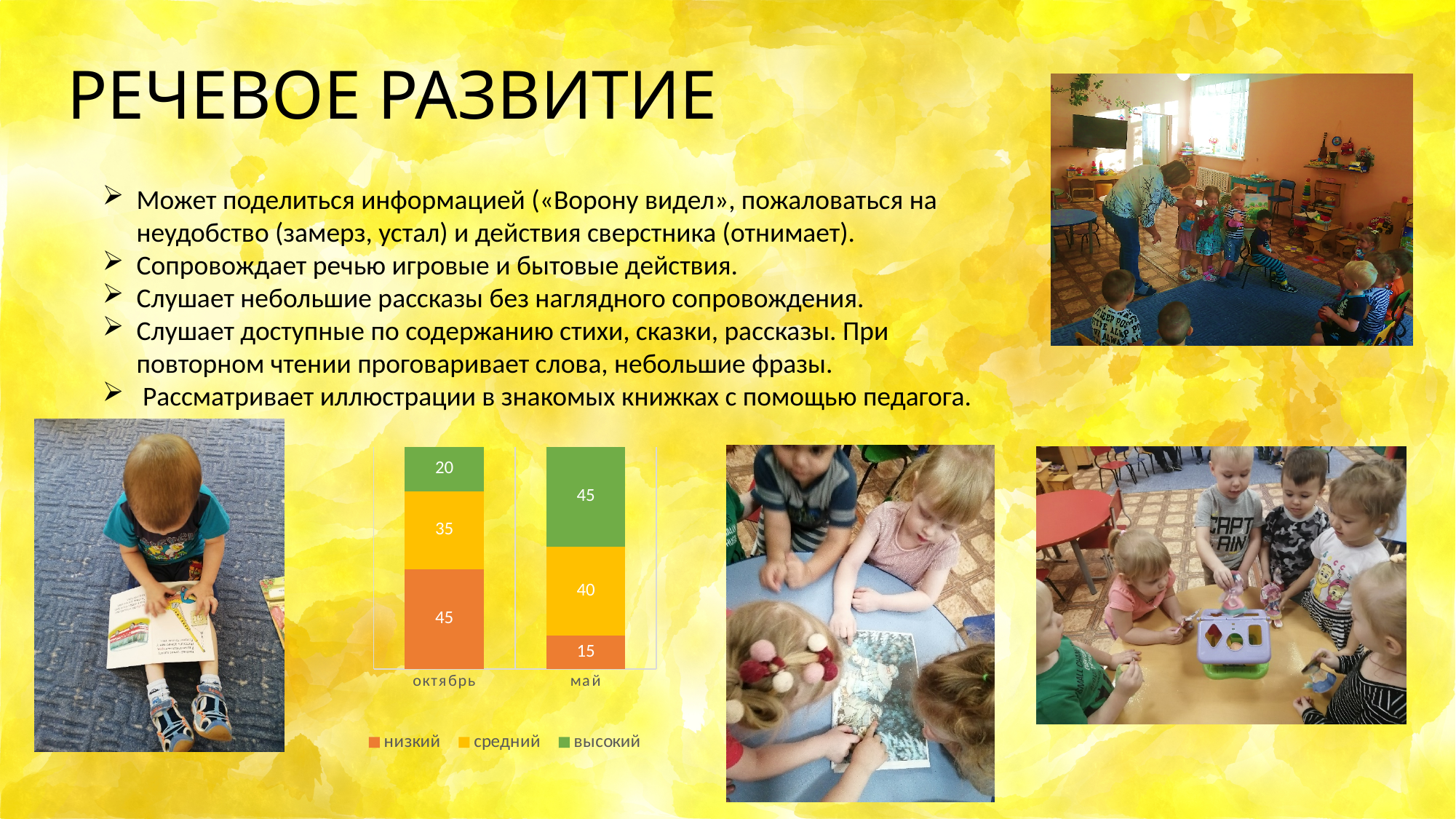
What is the value for высокий in май? 45 Which series has the lowest value in май? низкий Which series has the highest value in октябрь? низкий What is the value for низкий in октябрь? 45 Which is larger: высокий in октябрь or высокий in май? май How many categories are shown on the x axis? 2 What kind of chart is shown on the slide? stacked bar chart What is the value for низкий in май? 15 What is the value for средний in октябрь? 35 How many series does the legend list? 3 What is the difference between the низкий values for октябрь and май? 30 What is the total of the stacked bar for май? 100